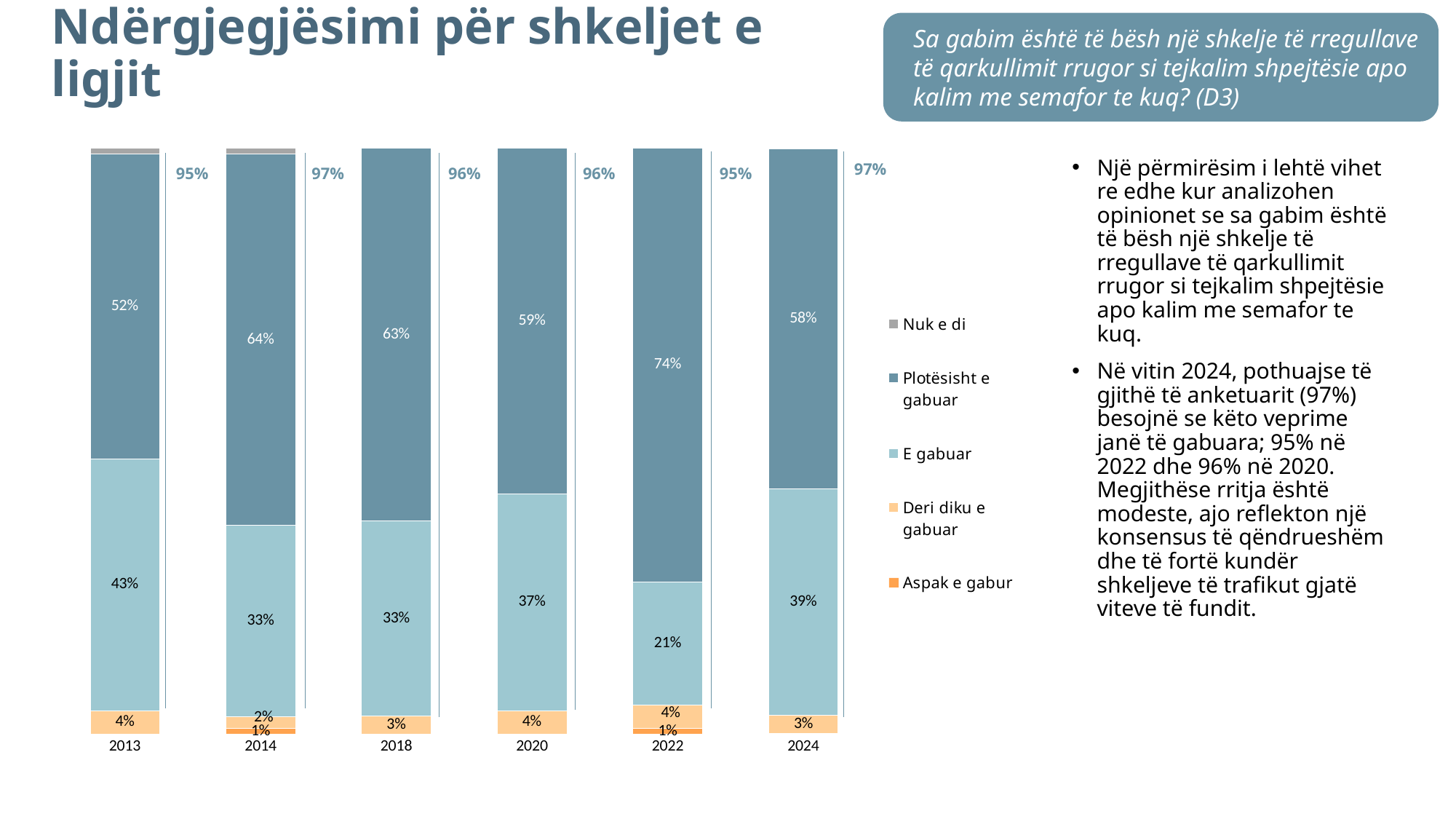
What is the value for 'E gabuar' in 2013? 43% In which year is the 'E gabuar' share the lowest? 2022 How many years (categories) are shown on the x axis of the chart? 6 What is the value for 'Deri diku e gabuar' in 2020? 4% What is the value for 'Plotësisht e gabuar' in 2022? 74% In which year is the 'Plotësisht e gabuar' share the highest? 2022 What type of chart is shown on the slide? stacked bar chart Which legend entry is shown in orange? Aspak e gabur What is the difference between the 'Plotësisht e gabuar' values in 2022 and 2024? 16% What combined percentage is labelled next to the 2024 bar? 97% Which is larger: 'E gabuar' in 2020 or 'E gabuar' in 2024? 2024 How many series does the chart legend list? 5